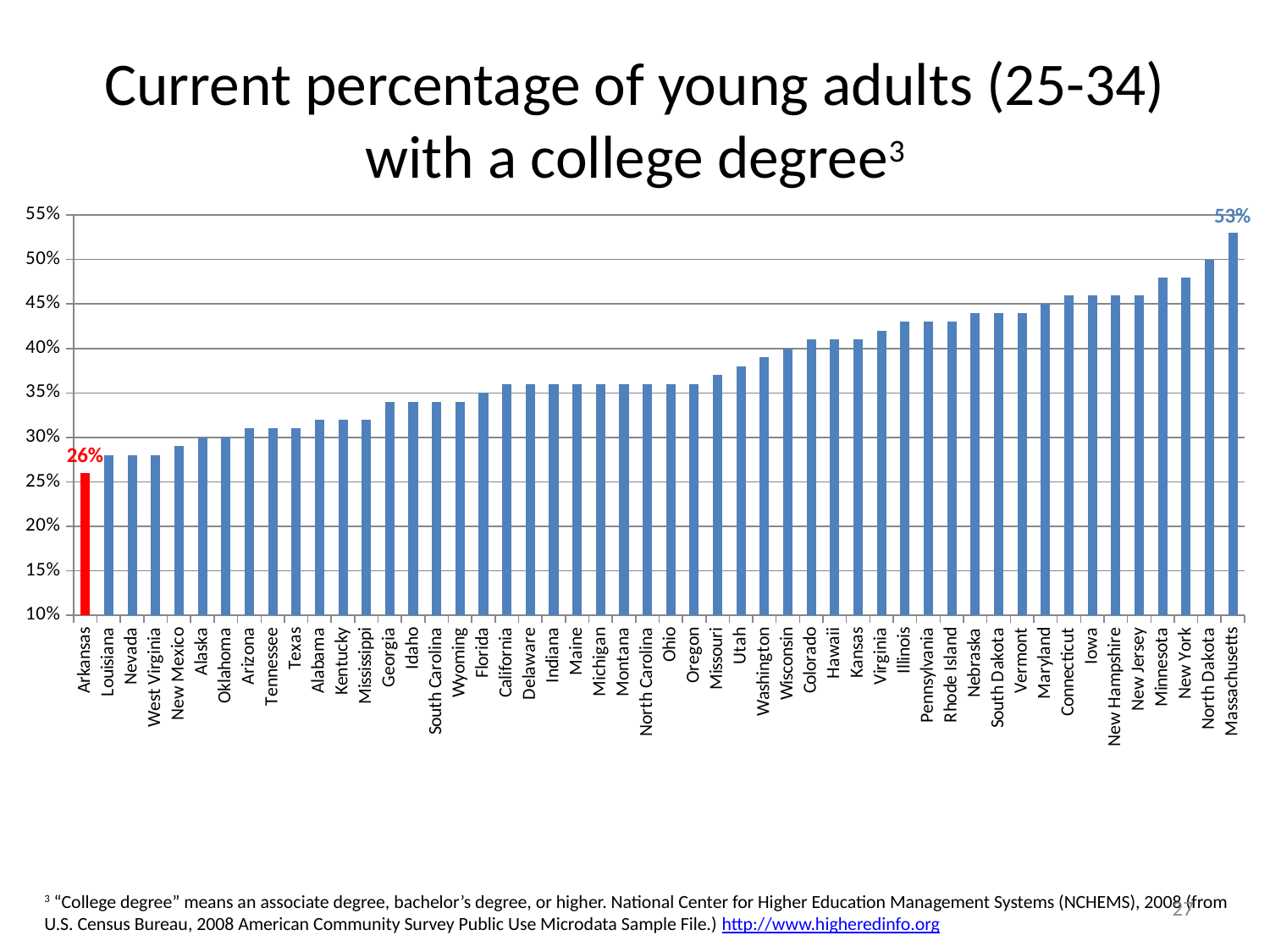
Which state's bar is highlighted in red? Arkansas Which state has the lowest percentage of young adults with a college degree? Arkansas Which state has a higher percentage of young adults with a college degree, New York or Louisiana? New York How many percentage points higher is Massachusetts than Arkansas? 27 percentage points Is the value for Vermont greater or less than 40%? greater What is the percentage of young adults with a college degree in Massachusetts? 53% What kind of chart is shown on the slide? Bar chart How many states are shown in the chart? 50 What is the percentage of young adults with a college degree in Arkansas? 26% Is the value for Georgia greater or less than 30%? greater Is the value for Texas greater or less than 35%? less Which state has the highest percentage of young adults with a college degree? Massachusetts